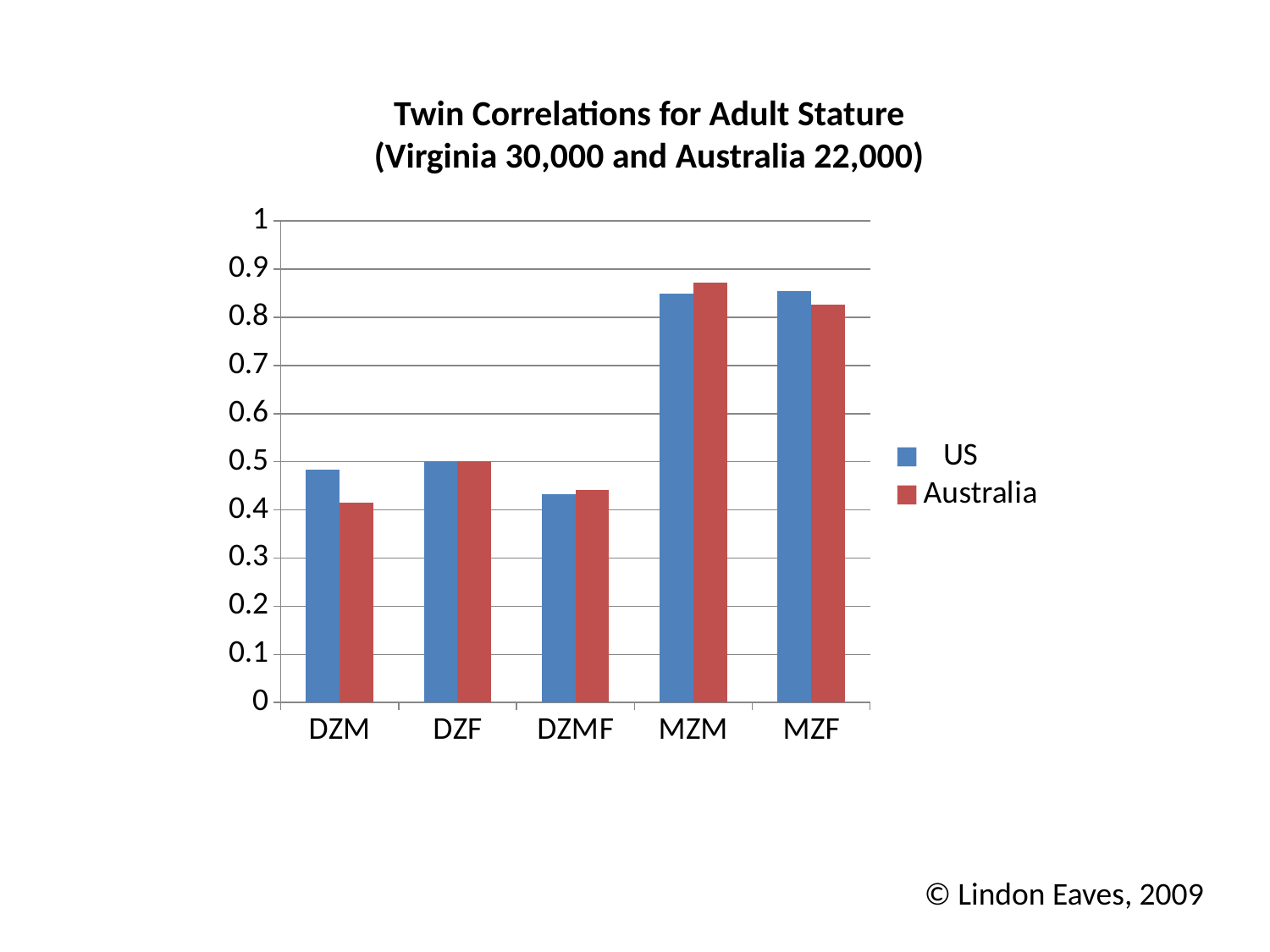
Which series does the red bar represent? Australia Which category has the highest Australia value? MZM Is the US value for DZMF greater or less than 0.5? less For DZM, which is larger, the US value or the Australia value? US Is the Australia value for DZM greater or less than 0.5? less What kind of chart is shown on the slide? bar chart What is the title of the chart? Twin Correlations for Adult Stature (Virginia 30,000 and Australia 22,000) How many twin categories are shown on the x axis? 5 Is the US value for MZF greater or less than 0.8? greater Which category has the lowest US value? DZMF How many series does the legend list? 2